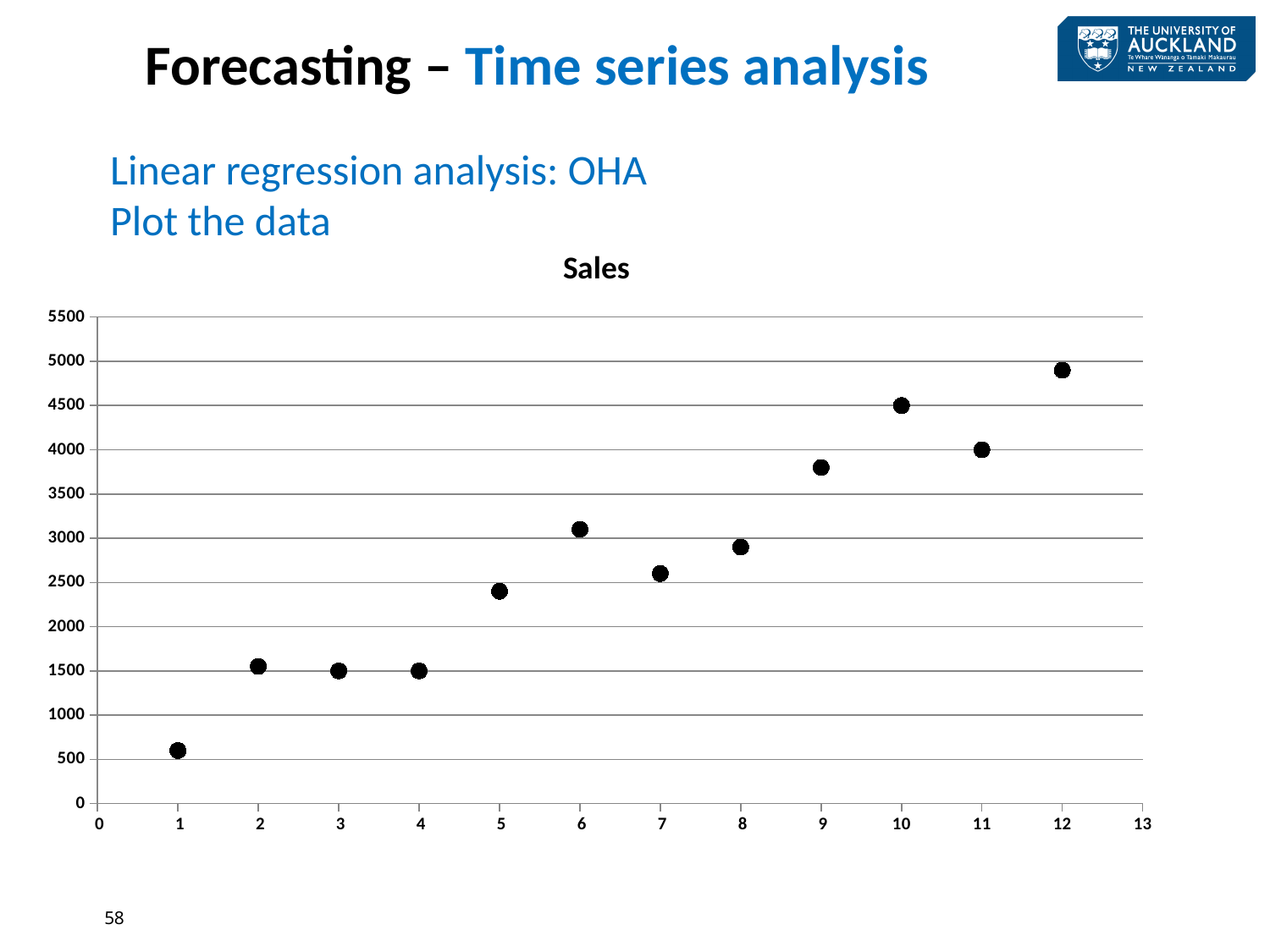
What type of chart is shown on the slide? scatter chart Is the value at x = 1 greater or less than 1000? less Do the values generally rise or fall as x increases? rise What is the title of the chart? Sales At which x value is the highest point on the chart? 12 How many data points are plotted on the chart? 12 What is the value at x = 11? 4000 Which has the larger value, the point at x = 6 or the point at x = 7? x = 6 What is the value at x = 3? 1500 Is the value at x = 12 greater or less than 5000? less At which x value is the lowest point on the chart? 1 Is the value at x = 6 greater or less than 3000? greater